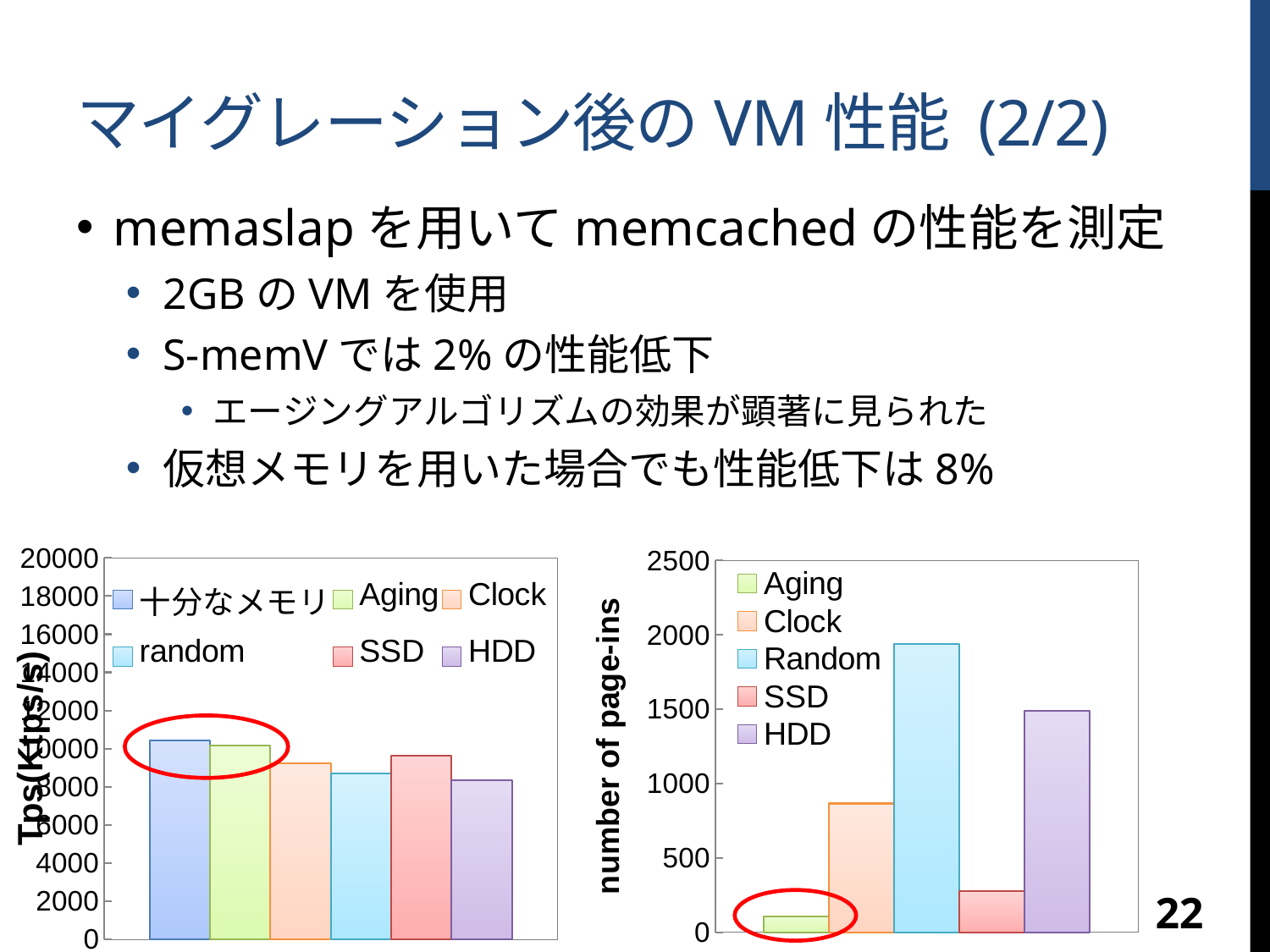
In the right chart (number of page-ins), is the value for Random greater or less than 1500? greater What is the y-axis label of the right chart? number of page-ins How many series does the legend of the left chart (Tps) list? 6 In the right chart (number of page-ins), which series has the lowest value? Aging In the right chart (number of page-ins), which series has the highest value? Random In the left chart (Tps), is the value for HDD greater or less than 10000? less In the left chart (Tps), which is larger, SSD or random? SSD In the left chart (Tps), is the value for 十分なメモリ greater or less than 10000? greater In the right chart (number of page-ins), which is larger, HDD or Clock? HDD What kind of chart is the left chart (Tps)? bar chart How many series does the legend of the right chart (number of page-ins) list? 5